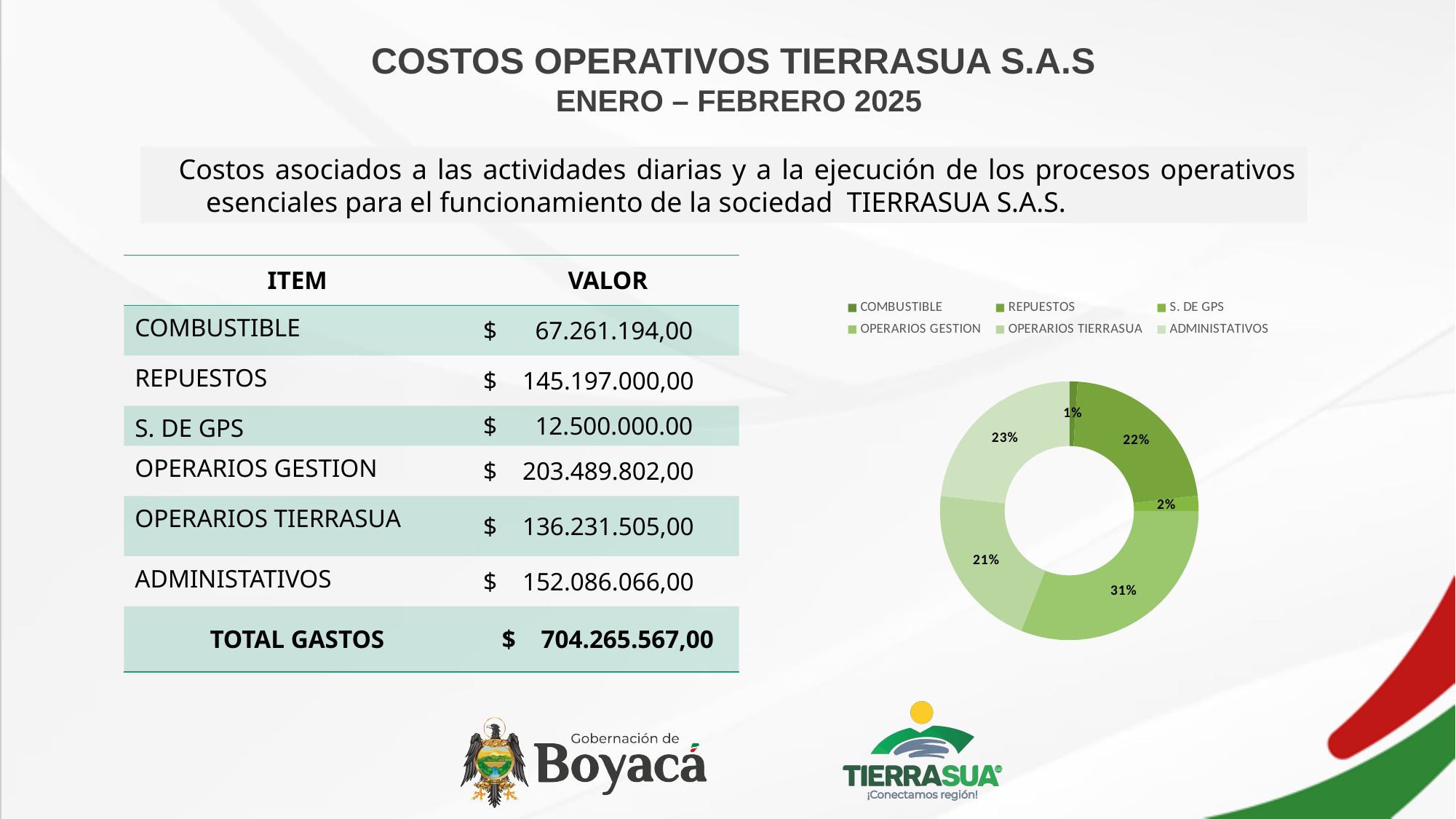
Which slice is larger, the one labelled 23% or the one labelled 21%? the 23% slice Which legend entry appears first in the chart's legend? COMBUSTIBLE How many categories does the chart's legend list? 6 What kind of chart is shown on the right of the slide? doughnut (pie) chart What share of the doughnut chart does COMBUSTIBLE (the darkest green slice) represent? 1% How many slices does the doughnut chart have? 6 What share of the doughnut chart does S. DE GPS (the slice at the lower right) represent? 2% What share of the doughnut chart does OPERARIOS GESTION (the slice at the lower left) represent? 31% What is the smallest percentage labelled on the doughnut chart? 1% What is the largest percentage labelled on the doughnut chart? 31%